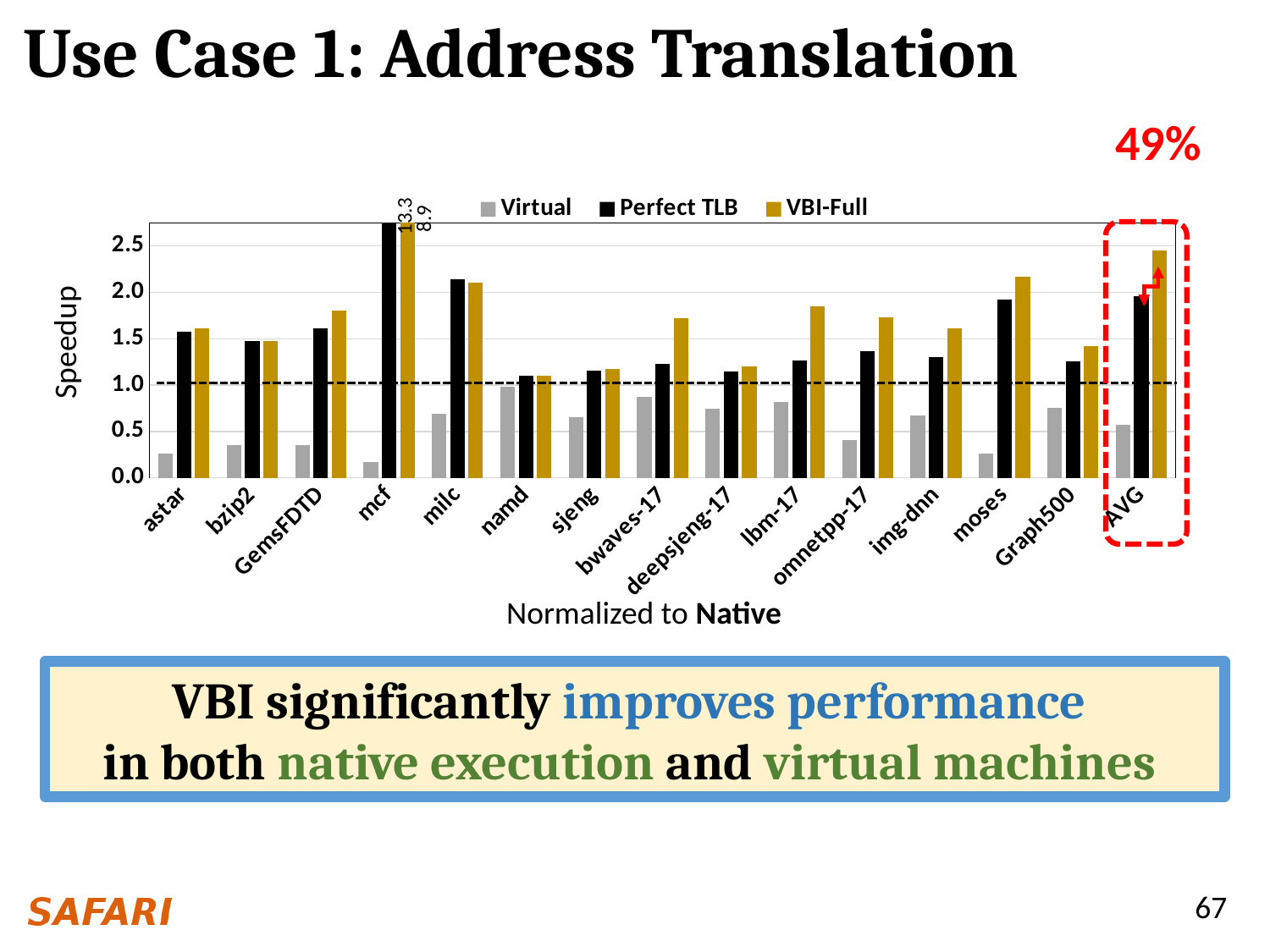
Which category has the lowest Virtual speedup? mcf Is the Virtual value for astar greater or less than 0.5? less What is the Perfect TLB speedup for mcf? 8.9 What is the label on the y axis of the chart? Speedup How many categories are shown along the x axis? 15 What is the difference between the Perfect TLB and VBI-Full values for mcf? 4.5 Is the VBI-Full value for AVG greater or less than 2.0? greater What is the VBI-Full speedup for mcf? 13.3 For mcf, which is larger: the Perfect TLB value or the VBI-Full value? VBI-Full Which category has the highest Perfect TLB speedup? mcf How many series does the legend list? 3 What kind of chart is shown on the slide? bar chart